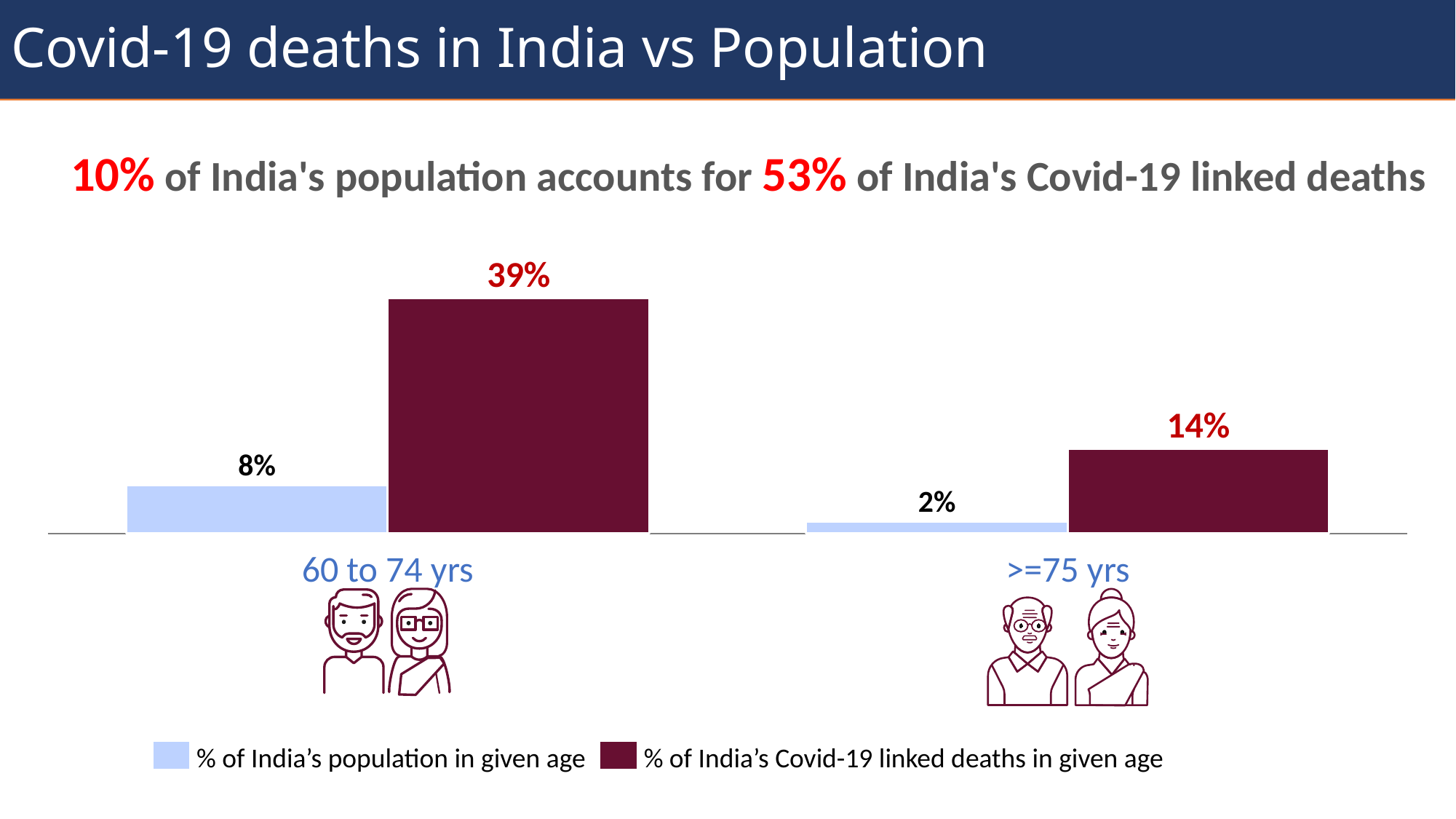
What is the difference between the share of Covid-19 linked deaths and the share of population for the 60 to 74 yrs group? 31 percentage points How many series does the legend list? 2 What percentage of India's population is in the 60 to 74 yrs age group? 8% What percentage of India's Covid-19 linked deaths are in the 60 to 74 yrs age group? 39% Which age group has the lower share of India's population? >=75 yrs Which age group has the higher share of India's Covid-19 linked deaths? 60 to 74 yrs What percentage of India's population is in the >=75 yrs age group? 2% What is the difference between the share of Covid-19 linked deaths and the share of population for the >=75 yrs group? 12 percentage points How many age groups are shown on the chart? 2 What type of chart is shown on the slide? bar chart Is the share of Covid-19 linked deaths for the >=75 yrs group larger or smaller than the share of Covid-19 linked deaths for the 60 to 74 yrs group? smaller What percentage of India's Covid-19 linked deaths are in the >=75 yrs age group? 14%